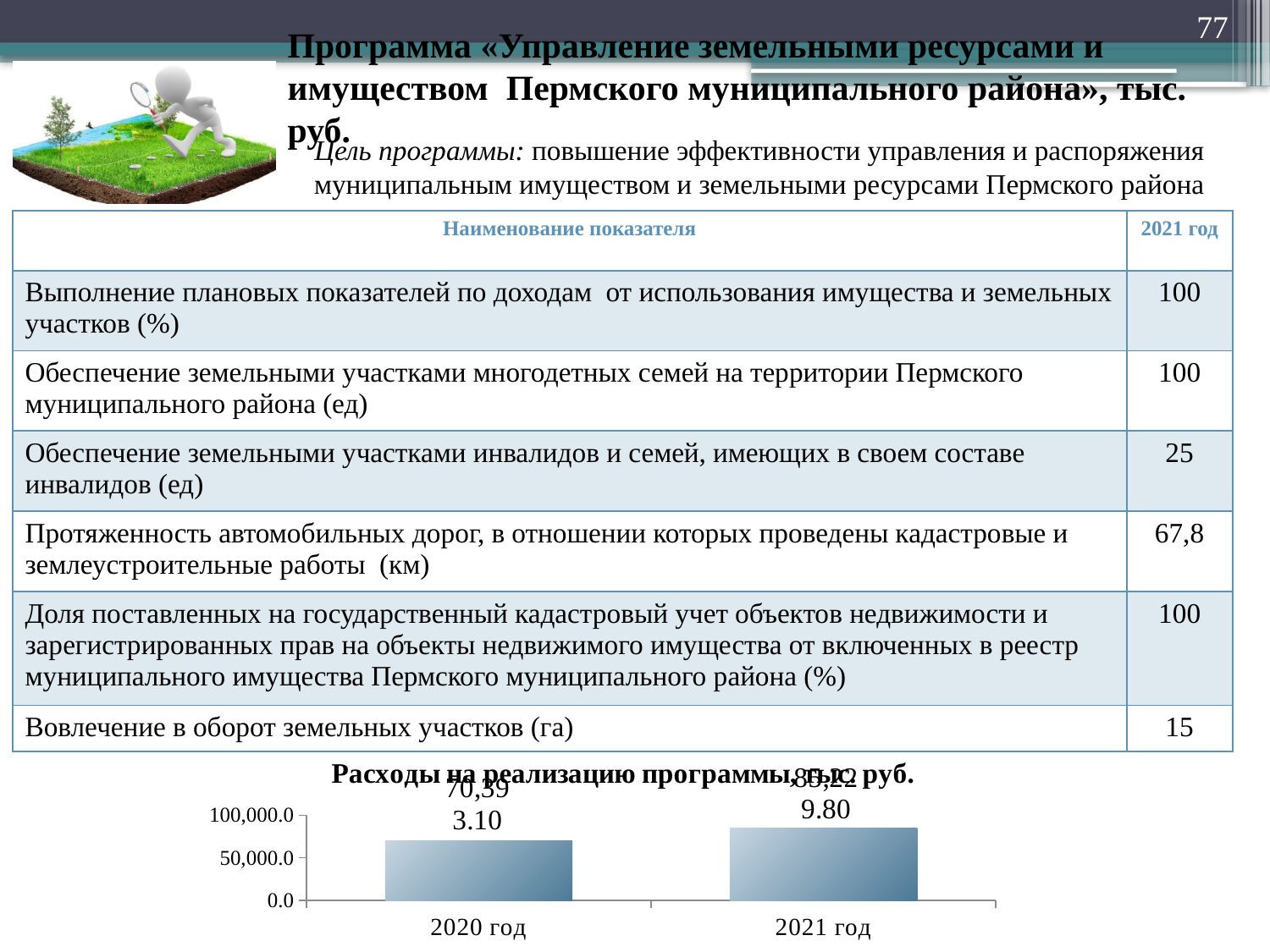
How many bars (categories) does the chart show? 2 What is the highest tick value shown on the vertical axis of the chart? 100,000.0 Is the value for 2020 год greater or less than 50,000.0? greater Is the value for 2020 год greater or less than 100,000.0? less Is the value for 2021 год greater or less than 100,000.0? less Is the bar for 2021 год larger or smaller than the bar for 2020 год? larger Which year has the higher bar in the chart? 2021 год What kind of chart is shown at the bottom of the slide? bar chart Which year has the lower bar in the chart? 2020 год Do the values rise or fall from 2020 год to 2021 год? rise What is the title of the chart at the bottom of the slide? Расходы на реализацию программы, тыс. руб.